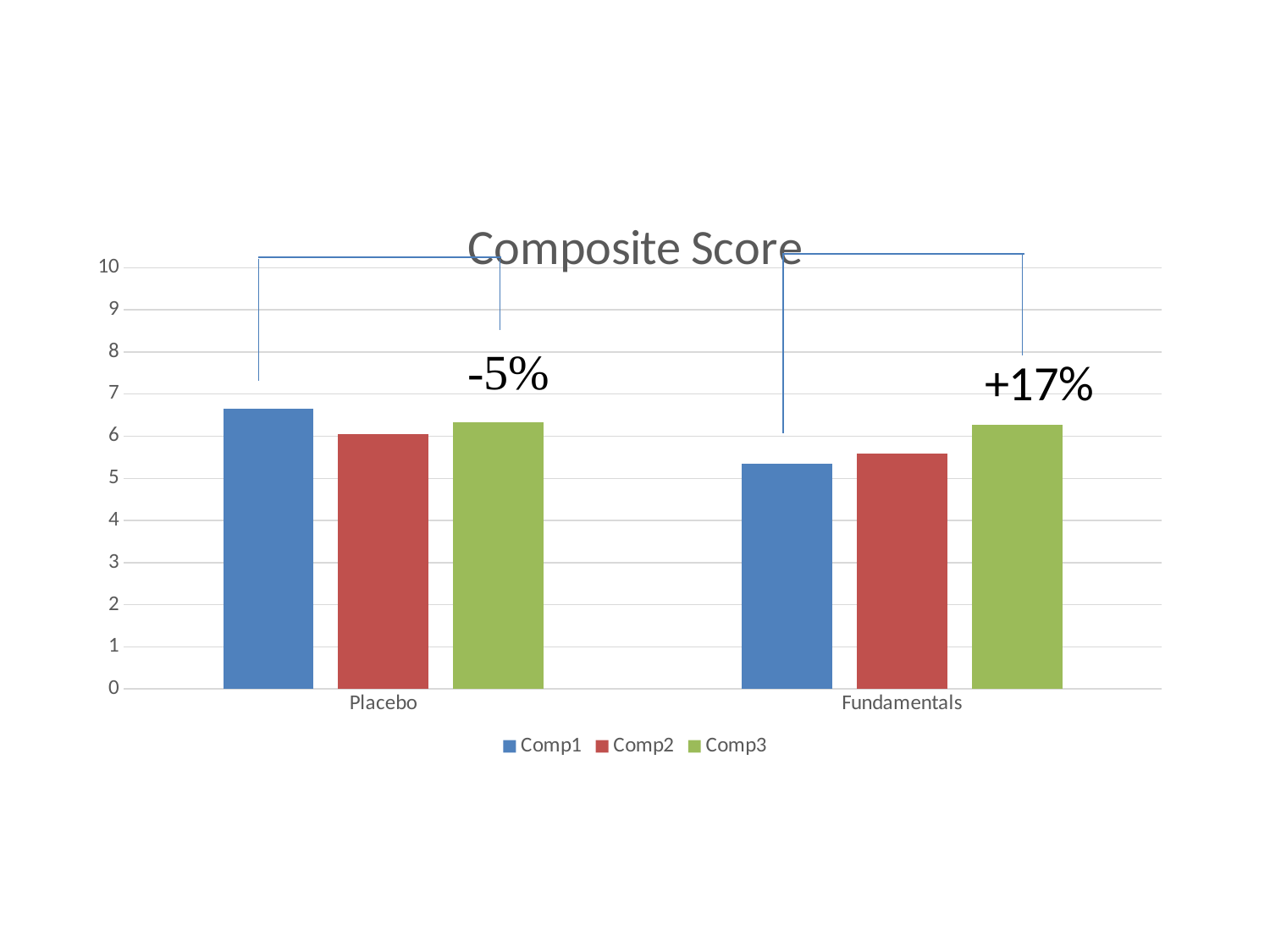
Is the value for Comp3 in the Placebo group greater or less than 6? greater What type of chart is shown on the slide? bar chart Is the value for Comp1 in the Fundamentals group greater or less than 6? less How many series does the legend list? 3 Which series has the highest value in the Placebo group? Comp1 Which is larger, the Comp1 value for Placebo or the Comp1 value for Fundamentals? Placebo How many categories are shown on the x axis? 2 Is the value for Comp1 in the Placebo group greater or less than 6? greater What is the title of the chart? Composite Score What percentage change is annotated above the Fundamentals group? +17% Which series has the highest value in the Fundamentals group? Comp3